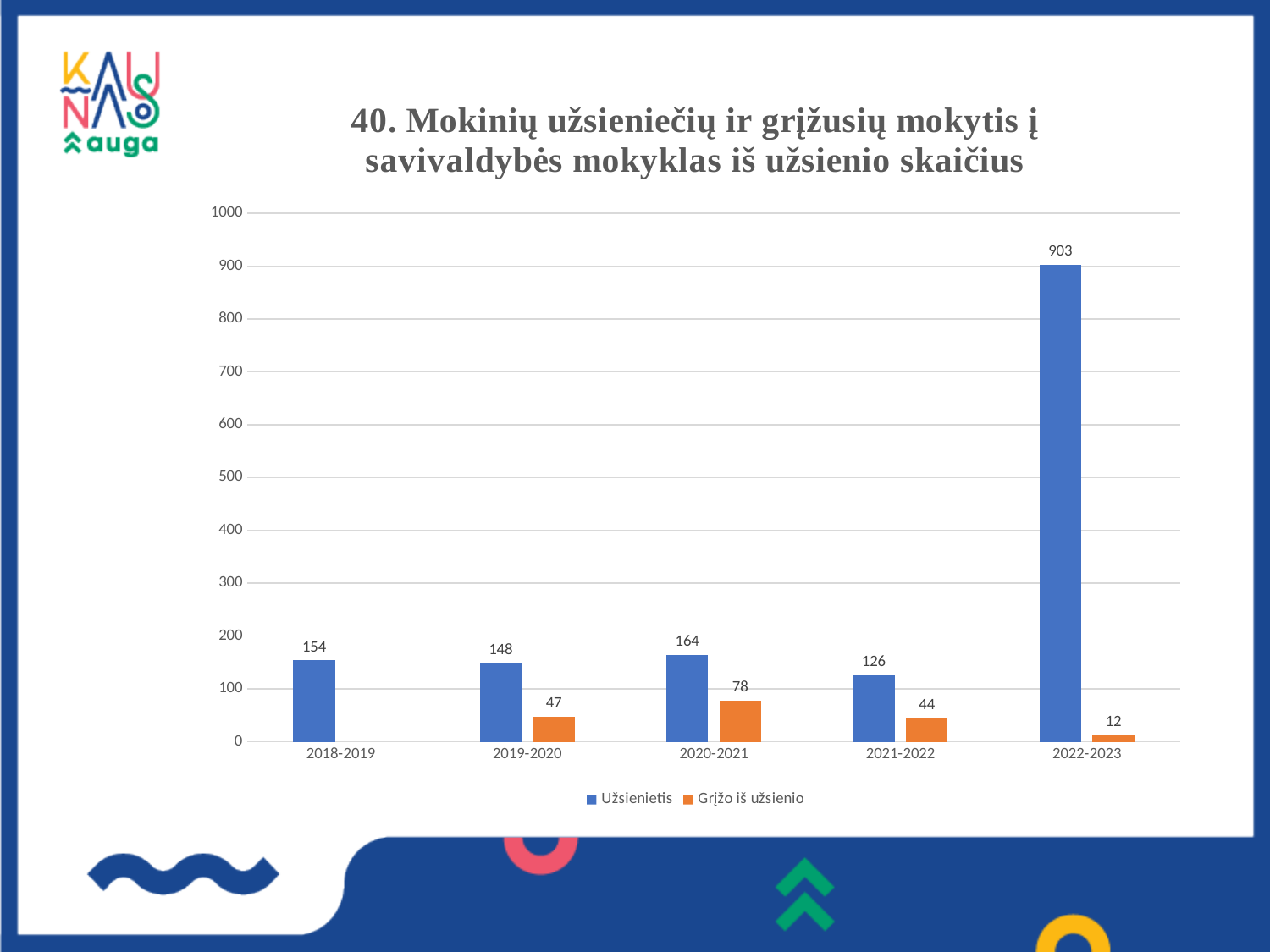
Is the value for Užsienietis in 2022-2023 greater or less than 800? greater Which year has the highest value for Užsienietis? 2022-2023 How many series does the legend list? 2 Which is larger: Užsienietis in 2019-2020 or Užsienietis in 2020-2021? Užsienietis in 2020-2021 How many school years are shown on the x axis? 5 What is the value for Užsienietis in 2022-2023? 903 What is the difference between the Užsienietis and Grįžo iš užsienio values in 2021-2022? 82 What is the value for Užsienietis in 2018-2019? 154 Which colour represents the Grįžo iš užsienio series? orange What kind of chart is shown on the slide? bar chart Which year has the lowest value for Grįžo iš užsienio among the years where it is shown? 2022-2023 What is the value for Grįžo iš užsienio in 2020-2021? 78